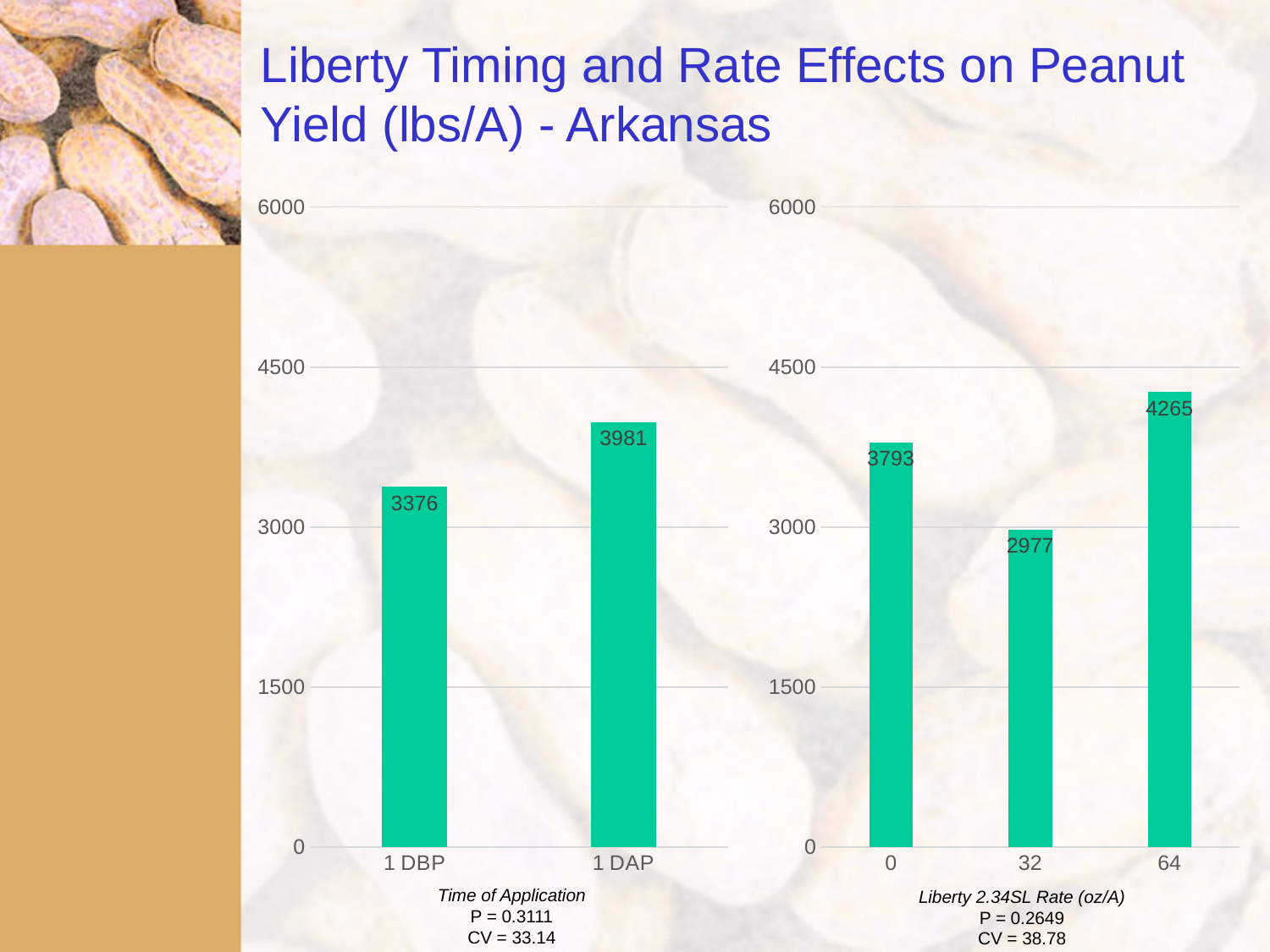
What kind of chart is the right chart (Liberty 2.34SL Rate)? bar chart In the left chart (Time of Application), what is the yield for 1 DBP? 3376 In the right chart (Liberty 2.34SL Rate), what is the yield at the 32 oz/A rate? 2977 In the left chart (Time of Application), what is the difference in yield between 1 DAP and 1 DBP? 605 In the right chart (Liberty 2.34SL Rate), what is the difference in yield between the 64 and 0 oz/A rates? 472 In the right chart (Liberty 2.34SL Rate), what is the yield at the 64 oz/A rate? 4265 In the left chart (Time of Application), how many categories are shown on the x axis? 2 In the right chart (Liberty 2.34SL Rate), which rate has the highest yield? 64 In the left chart (Time of Application), which time of application has the higher yield? 1 DAP In the right chart (Liberty 2.34SL Rate), which rate has the lowest yield? 32 In the right chart (Liberty 2.34SL Rate), is the yield at the 0 oz/A rate greater or less than 3000? greater In the left chart (Time of Application), what is the yield for 1 DAP? 3981